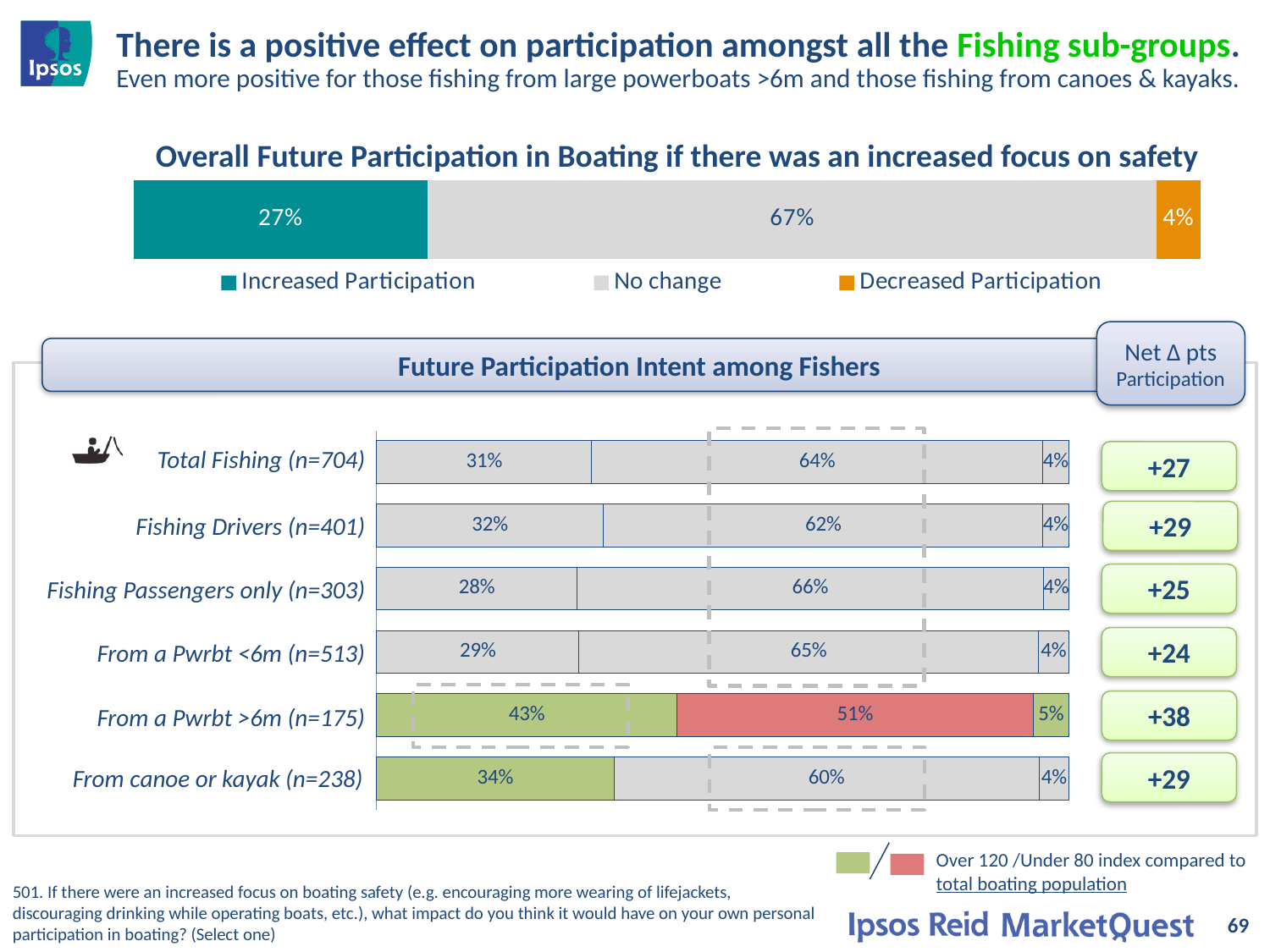
How many sub-groups are shown in the 'Future Participation Intent among Fishers' chart? 6 In the 'Future Participation Intent among Fishers' chart, which sub-group has the highest Increased Participation percentage? From a Pwrbt >6m (n=175) In the 'Overall Future Participation in Boating' chart, what percentage reported No change? 67% In the 'Future Participation Intent among Fishers' chart, which sub-group has the lowest Increased Participation percentage? Fishing Passengers only (n=303) What type of chart is the 'Future Participation Intent among Fishers' chart? Stacked bar chart In the 'Future Participation Intent among Fishers' chart, what is the difference in Increased Participation between From a Pwrbt >6m (n=175) and From a Pwrbt <6m (n=513)? 14 percentage points In the 'Future Participation Intent among Fishers' chart, what is the Increased Participation value for From a Pwrbt >6m (n=175)? 43% In the 'Future Participation Intent among Fishers' chart, what is the No change value for From canoe or kayak (n=238)? 60% In the 'Future Participation Intent among Fishers' chart, what is the Net Δ pts Participation for From a Pwrbt >6m (n=175)? +38 In the 'Overall Future Participation in Boating' chart, what percentage reported Increased Participation? 27% In the 'Overall Future Participation in Boating' chart, how many series does the legend list? 3 In the 'Future Participation Intent among Fishers' chart, which is larger: the Increased Participation for Fishing Drivers (n=401) or for Fishing Passengers only (n=303)? Fishing Drivers (n=401)